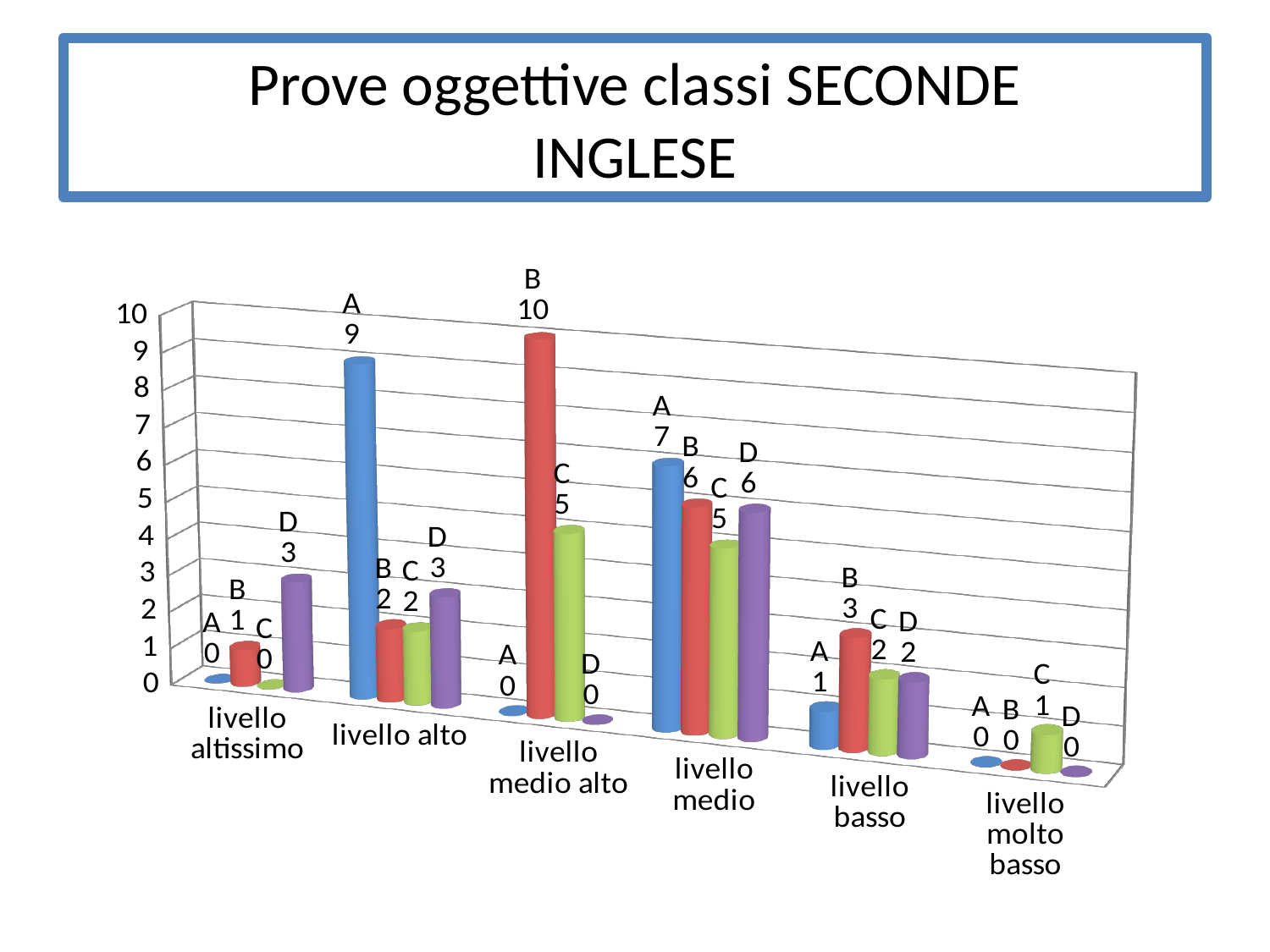
What kind of chart is shown on the slide? bar chart What is the value for series A in the 'livello alto' category? 9 What is the total of the four series values in the 'livello medio' category? 24 Which series has the highest value in the 'livello medio' category? A Which is larger: series A in 'livello alto' or series A in 'livello medio'? series A in 'livello alto' Which series has the lowest value in the 'livello basso' category? A What is the value for series C in the 'livello molto basso' category? 1 What is the value for series B in the 'livello medio alto' category? 10 How many categories are shown on the x axis? 6 What is the value for series D in the 'livello altissimo' category? 3 What is the difference between the values of series B and series C in the 'livello medio alto' category? 5 What is the title of the slide containing the chart? Prove oggettive classi SECONDE INGLESE